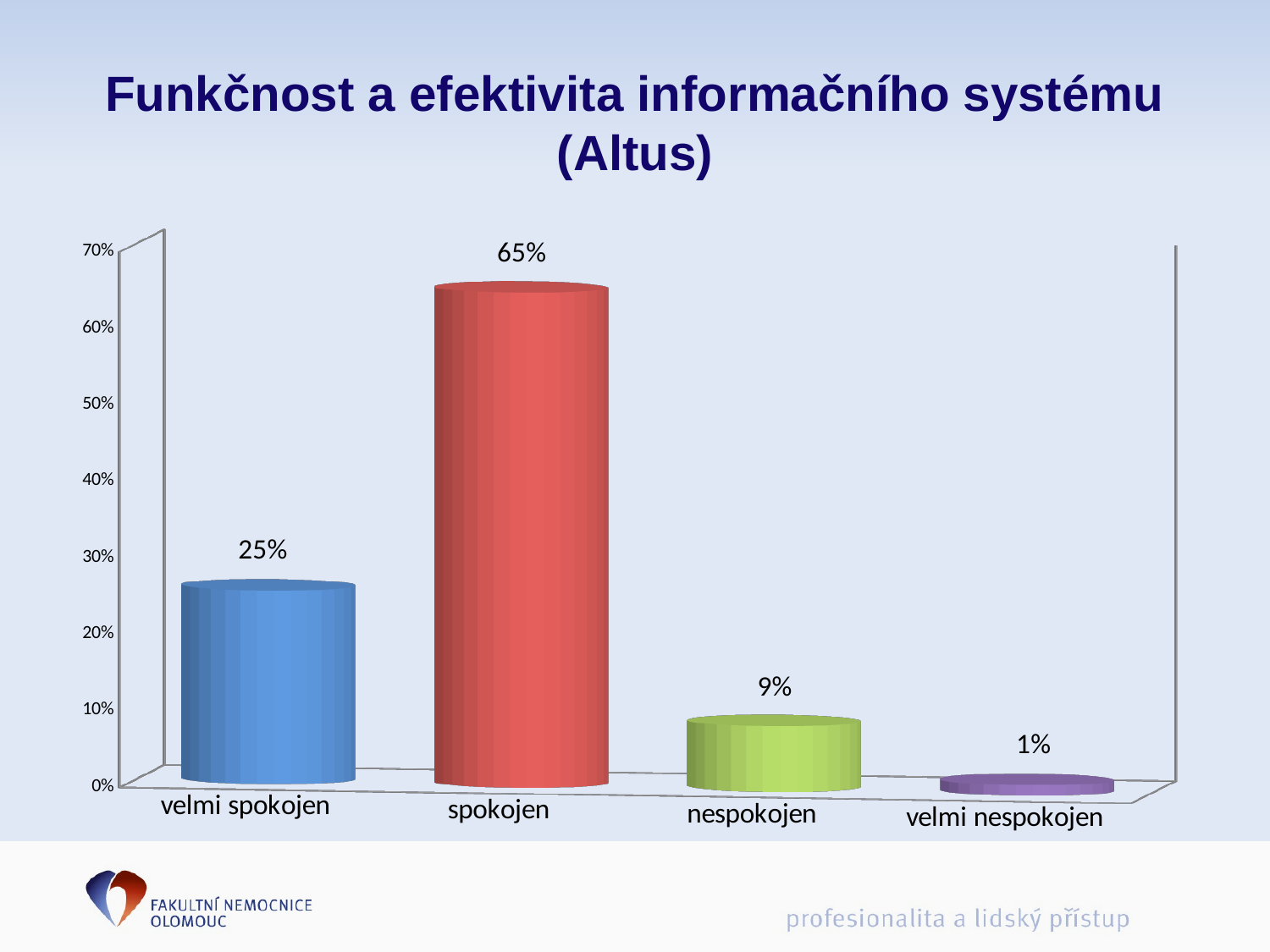
Which category has the lowest value? velmi nespokojen Is the value for "spokojen" greater or less than 60%? greater What is the title of the slide containing the chart? Funkčnost a efektivita informačního systému (Altus) What is the value for "spokojen"? 65% What is the value for "velmi spokojen"? 25% How many categories are shown on the chart? 4 Which is larger, the value for "velmi spokojen" or the value for "nespokojen"? velmi spokojen Which category has the highest value? spokojen What is the difference between the values for "spokojen" and "velmi spokojen"? 40% What is the value for "nespokojen"? 9% What is the value for "velmi nespokojen"? 1% What kind of chart is shown on the slide? bar chart